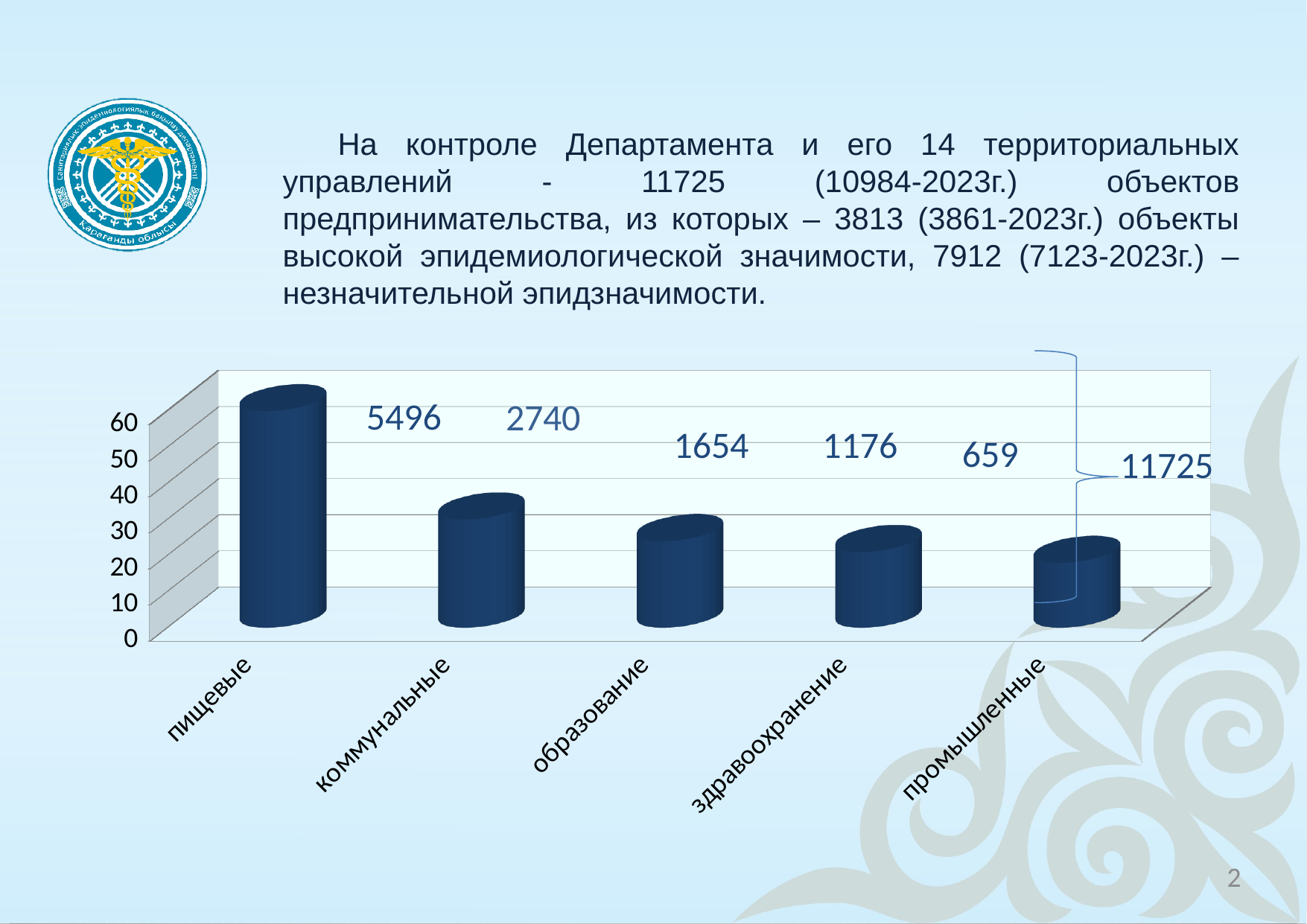
What is the difference between the values for пищевые and коммунальные? 2756 What kind of chart is shown on the slide? bar chart Which is larger, the value for образование or the value for здравоохранение? образование Which category has the highest value? пищевые What value is shown for the коммунальные category? 2740 How many categories are shown on the x axis? 5 Do the values rise or fall from left to right along the x axis? fall What value is shown for the пищевые category? 5496 What value is shown for the образование category? 1654 What value is shown for the промышленные category? 659 What value is shown for the здравоохранение category? 1176 Which category has the lowest value? промышленные